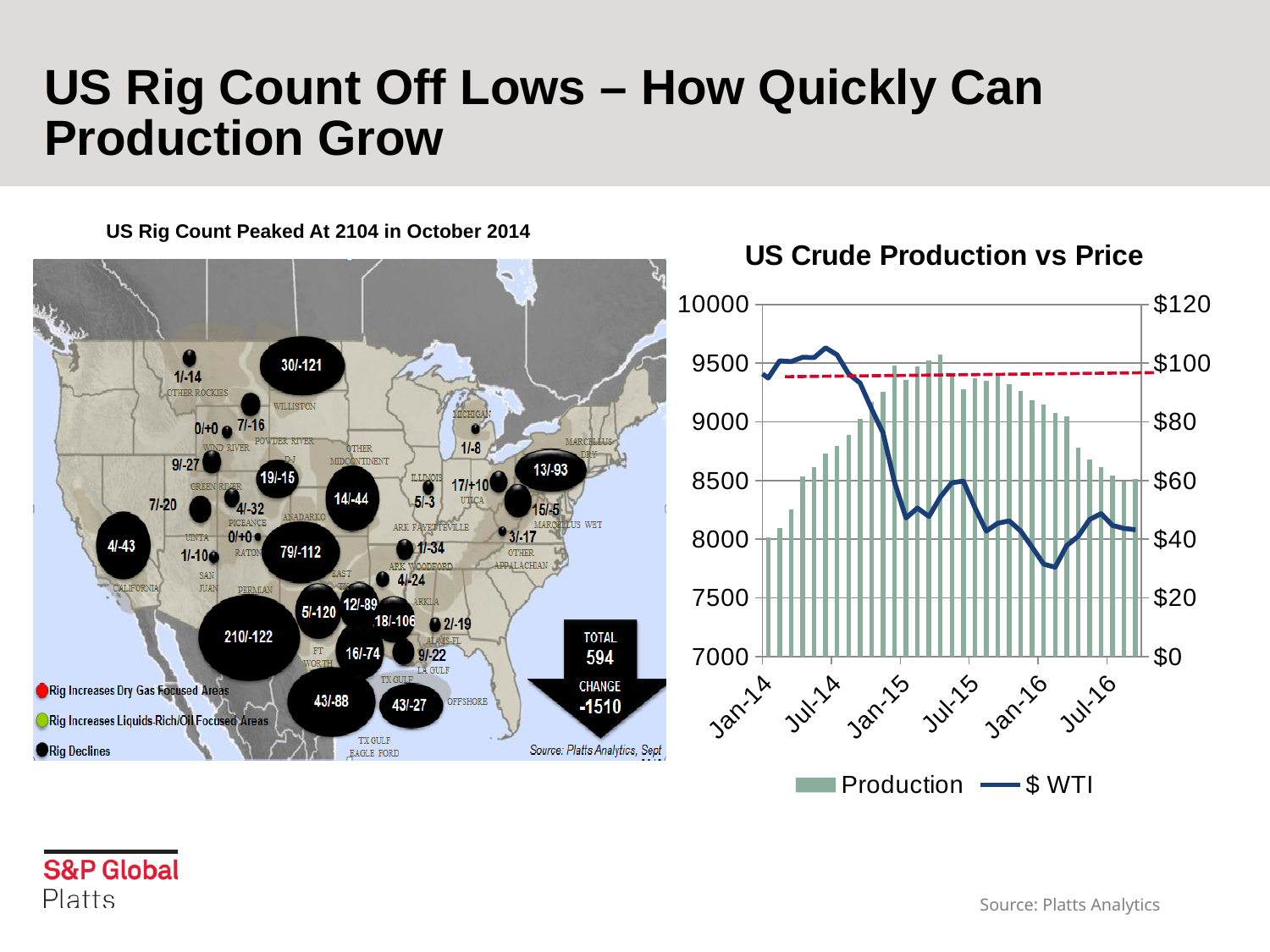
In the 'US Crude Production vs Price' chart, in which year do the Production bars reach their highest level? 2015 In the 'US Crude Production vs Price' chart, is the Production value at Jan-15 greater or less than 9000? greater On the rig count map on the left, what total rig count is shown? 594 In the 'US Crude Production vs Price' chart, which series is drawn as bars? Production How many series does the legend of the 'US Crude Production vs Price' chart list? 2 In the 'US Crude Production vs Price' chart, does Production rise or fall between Jan-14 and Jan-15? rise What kind of chart is the 'US Crude Production vs Price' chart? Combined bar and line chart In the 'US Crude Production vs Price' chart, is the Production value at Jul-16 greater or less than 9000? less In the 'US Crude Production vs Price' chart, is the $ WTI value at Jan-16 greater or less than $40? less On the rig count map on the left, what change in rig count is shown? -1510 In the 'US Crude Production vs Price' chart, does the $ WTI line rise or fall between Jul-14 and Jan-15? fall